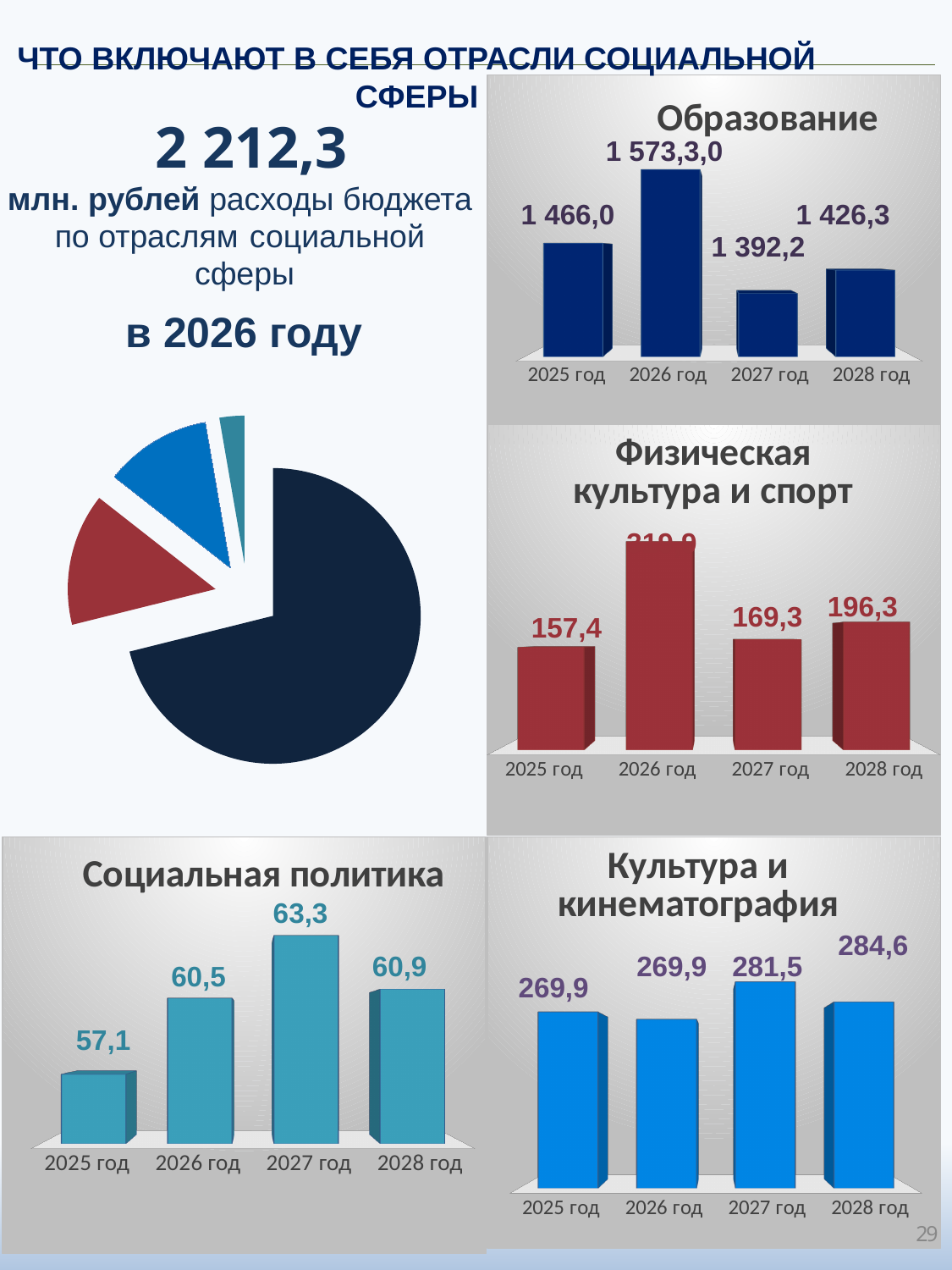
How many years (categories) are shown in the 'Культура и кинематография' chart? 4 In the 'Образование' chart, which year has the lowest value? 2027 год In the 'Образование' chart, what is the value for 2025 год? 1 466,0 In the 'Физическая культура и спорт' chart, what is the difference between the values for 2028 год and 2027 год? 27,0 In the 'Образование' chart, which year has the highest value? 2026 год In the 'Культура и кинематография' chart, what is the difference between the values for 2028 год and 2027 год? 3,1 In the 'Культура и кинематография' chart, what is the value for 2028 год? 284,6 In the 'Социальная политика' chart, what is the value for 2027 год? 63,3 In the 'Социальная политика' chart, which is larger: the value for 2026 год or 2028 год? 2028 год In the 'Физическая культура и спорт' chart, what is the value for 2028 год? 196,3 In the 'Социальная политика' chart, which year has the lowest value? 2025 год What kind of chart is shown on the left side of the slide below the text 'в 2026 году'? Pie chart